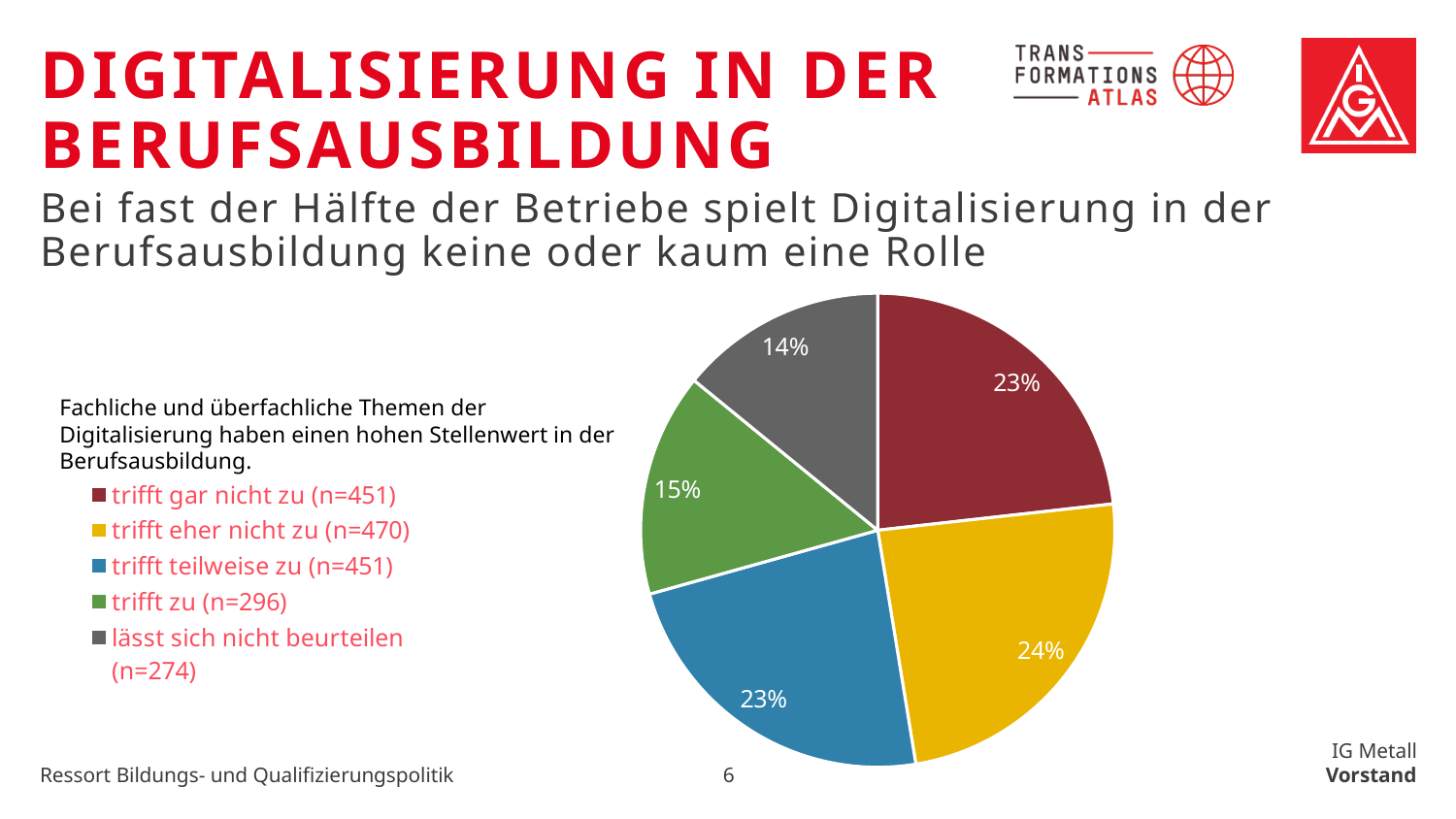
What kind of chart is shown on the slide? pie chart Which category has the largest share of the pie? trifft eher nicht zu (n=470) What share of the pie does "trifft teilweise zu (n=451)" have? 23% What is the difference in percentage points between "trifft eher nicht zu (n=470)" and "trifft zu (n=296)"? 9 What share of the pie does "trifft eher nicht zu (n=470)" have? 24% Which category has the smallest share of the pie? lässt sich nicht beurteilen (n=274) What share of the pie does "trifft zu (n=296)" have? 15% What colour is the slice for "trifft teilweise zu (n=451)"? blue How many slices does the pie chart have? 5 Which is larger, the share for "trifft zu (n=296)" or the share for "trifft teilweise zu (n=451)"? trifft teilweise zu (n=451)